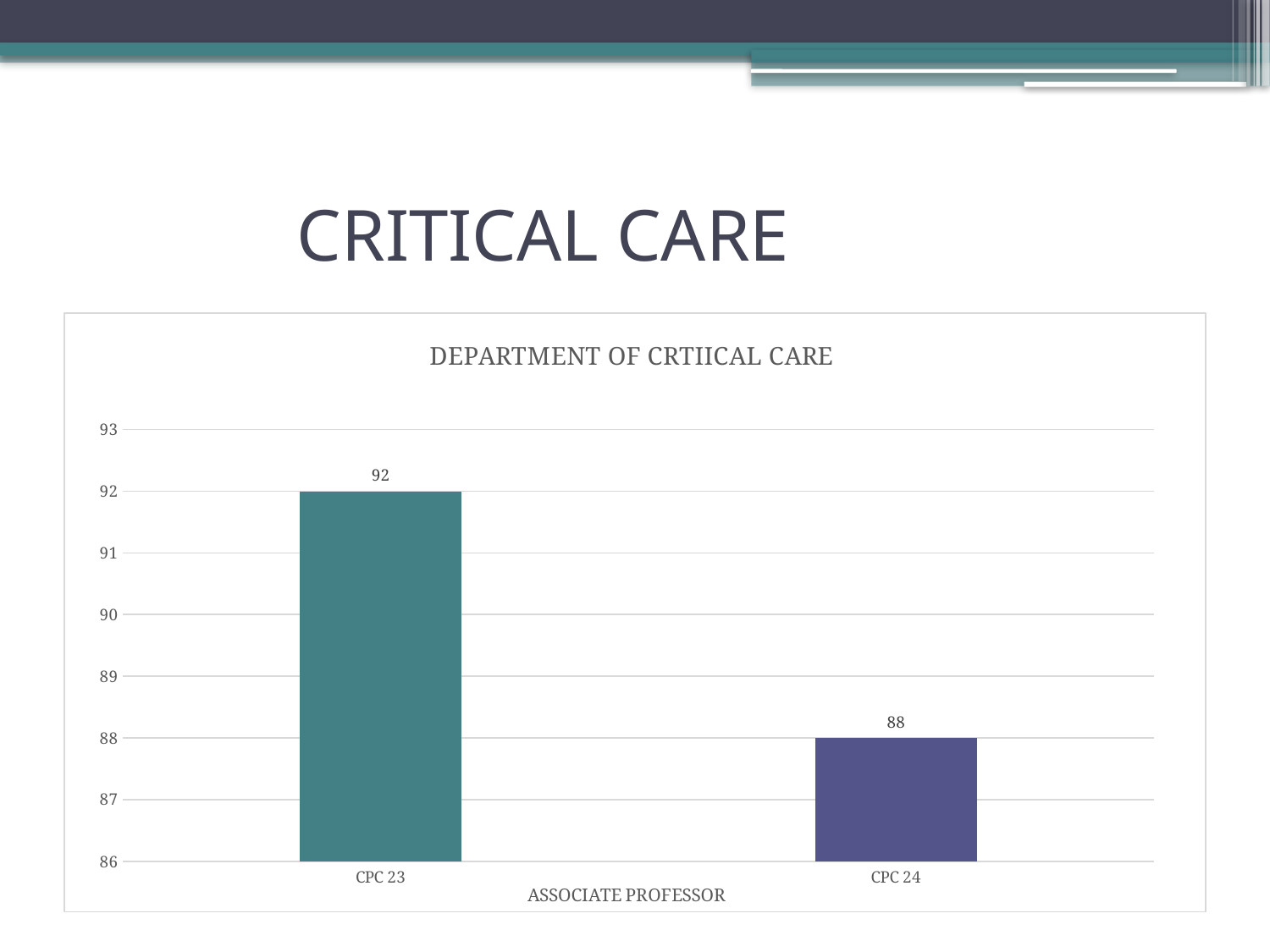
What is the difference between the values for CPC 23 and CPC 24? 4 What is the value for CPC 23? 92 Which category has the lowest value? CPC 24 Which is larger, the value for CPC 23 or the value for CPC 24? CPC 23 What is the title of the chart? DEPARTMENT OF CRTIICAL CARE How many categories are shown on the x axis? 2 What kind of chart is shown on the slide? bar chart What is the value for CPC 24? 88 Which category has the highest value? CPC 23 Is the value for CPC 24 greater or less than 90? less Is the value for CPC 23 greater or less than 90? greater Do the values rise or fall from CPC 23 to CPC 24? fall